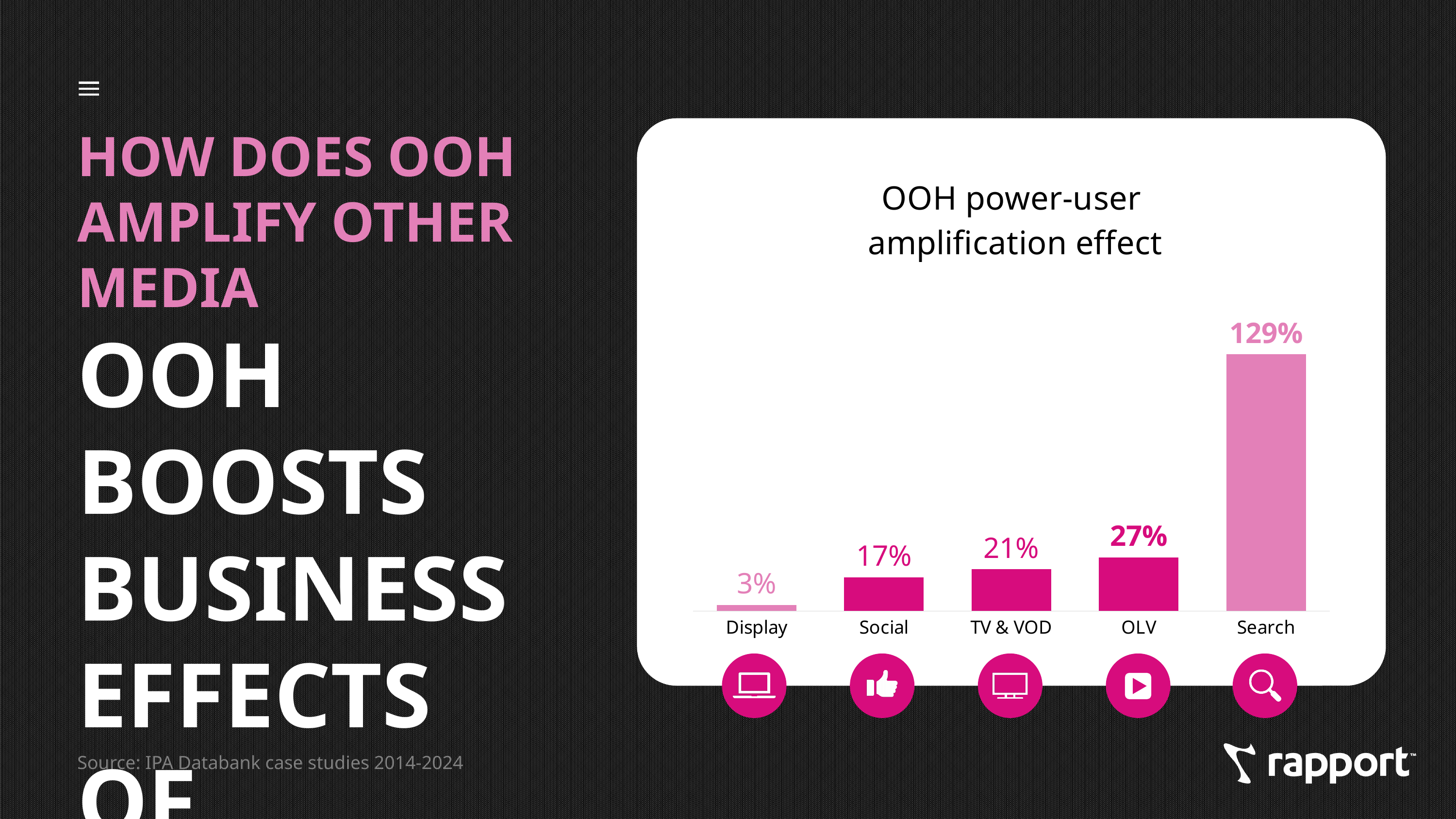
What is the value for Display? 3% What is the title of the chart? OOH power-user amplification effect What is the difference between the values for Search and OLV? 102% What is the value for TV & VOD? 21% What is the value for OLV? 27% What kind of chart is shown? Bar chart What is the difference between the values for Social and Display? 14% Which category has the lowest value? Display Which category has the highest value? Search What is the value for Search? 129% How many categories are shown in the chart? 5 Which is larger, the value for TV & VOD or the value for Social? TV & VOD